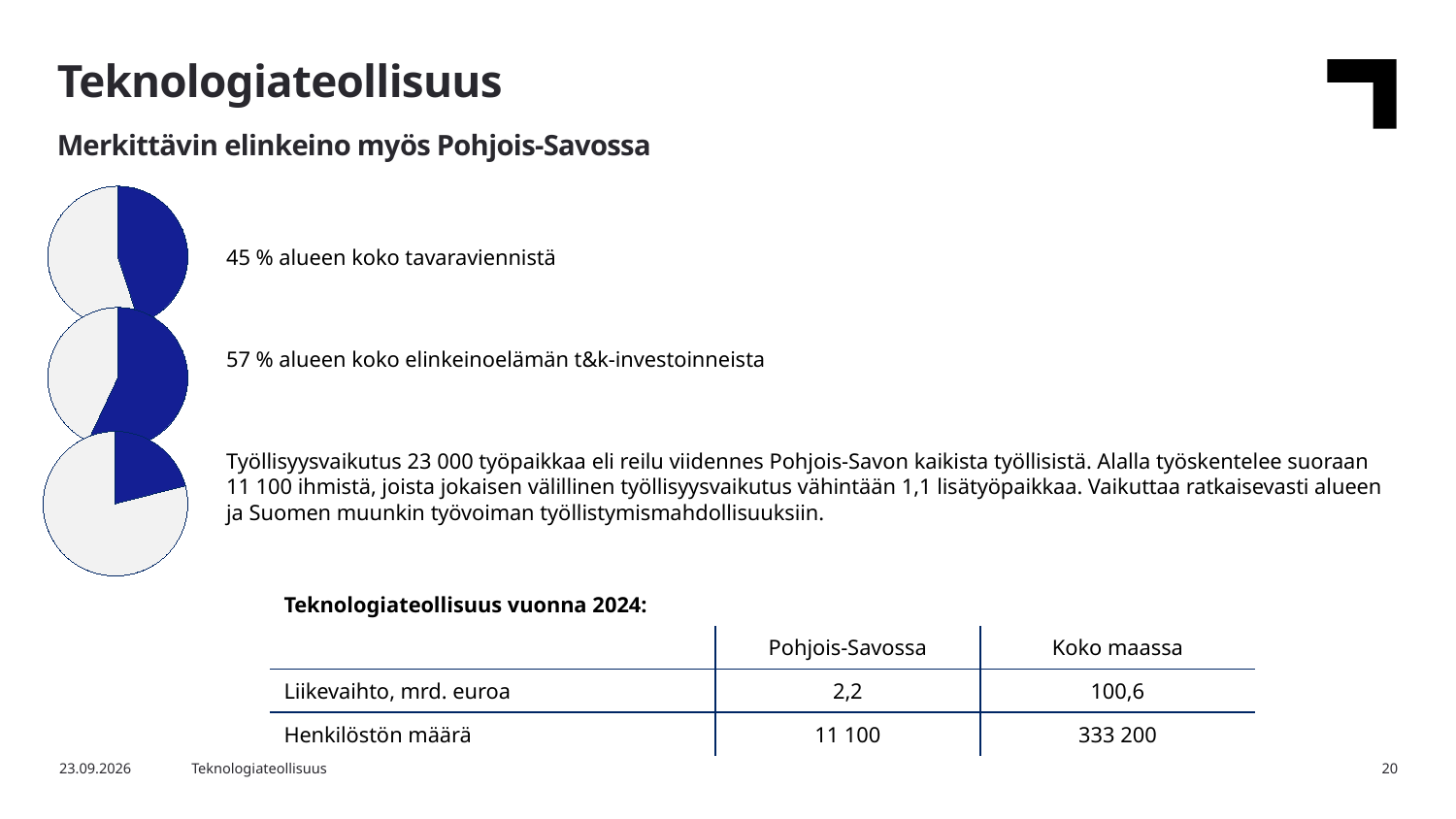
What is the difference in percentage points between the blue slice of the middle pie chart (57 %) and the blue slice of the top pie chart (45 %)? 12 percentage points Is the blue slice in the middle pie chart (t&k-investoinnit) greater or less than half of the pie? greater Is the blue slice in the top pie chart (tavaravienti) greater or less than half of the pie? less In the top pie chart, what share of the region's total goods exports (tavaravienti) does the blue slice represent? 45 % Which pie chart has the larger blue slice, the top one (tavaravienti) or the middle one (t&k-investoinnit)? The middle one (t&k-investoinnit) What kind of chart is used for the three graphics on the left side of the slide? Pie chart Of the three pie charts, which one has the smallest blue slice? The bottom one (työllisyysvaikutus) What colour is used for the highlighted slice in each pie chart? Dark blue Of the three pie charts, which one has the largest blue slice? The middle one (57 % of t&k-investoinnit) Which pie chart has the smaller blue slice, the top one (tavaravienti) or the bottom one (työllisyysvaikutus)? The bottom one (työllisyysvaikutus) In the middle pie chart, what share of the region's business R&D investments (t&k-investoinnit) does the blue slice represent? 57 % How many pie charts are shown on the slide? 3